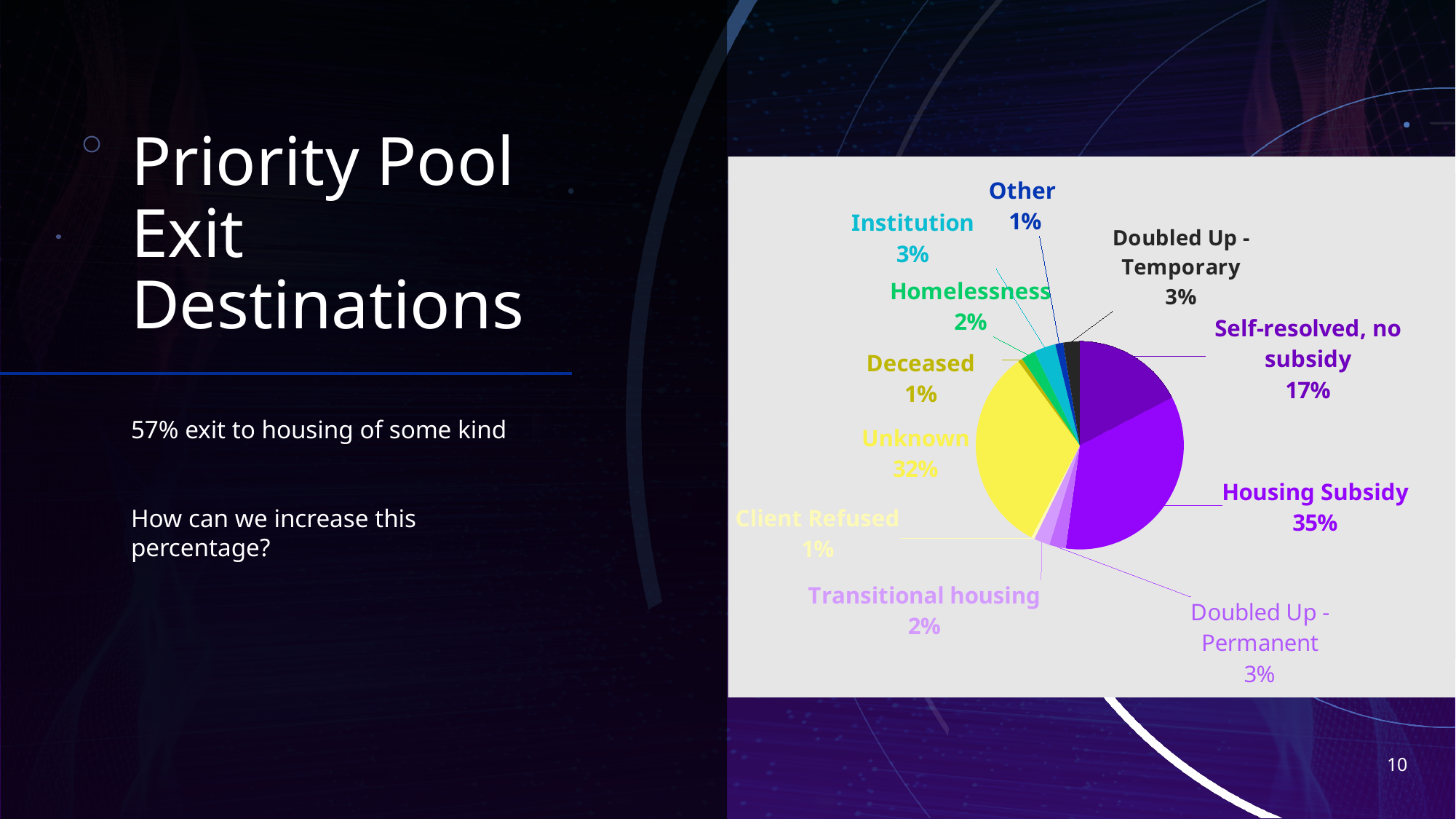
What is the difference in percentage points between Housing Subsidy and Self-resolved, no subsidy? 18 What share of the pie is Self-resolved, no subsidy? 17% What percentage of exits are Doubled Up - Temporary? 3% What percentage of exits are to Homelessness? 2% Which exit destination has the largest share of the pie? Housing Subsidy What percentage of exits go to Transitional housing? 2% What percentage of exits go to Housing Subsidy? 35% What percentage of exits are Unknown? 32% What type of chart is shown on the slide? Pie chart Which is larger, the share for Unknown or the share for Self-resolved, no subsidy? Unknown How many exit destination categories are shown in the pie chart? 11 What percentage of exits are Doubled Up - Permanent? 3%